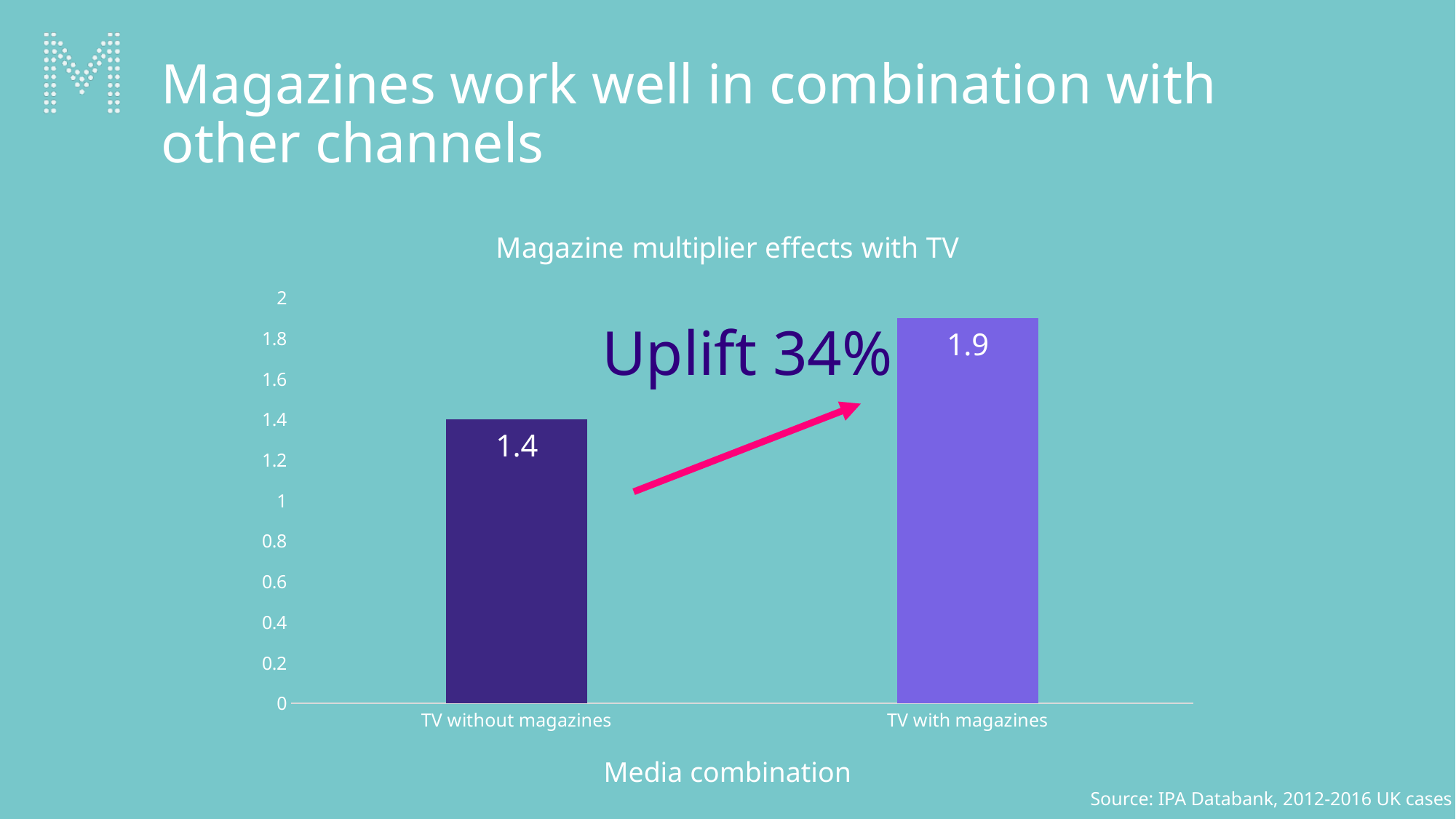
What is the title of the chart? Magazine multiplier effects with TV Which category has the lowest value? TV without magazines Which is larger, the value for TV with magazines or TV without magazines? TV with magazines Is the value for TV with magazines greater or less than 1.6? greater How many categories are shown on the x axis? 2 Which category has the highest value? TV with magazines What uplift percentage is annotated on the chart? 34% Is the value for TV without magazines greater or less than 1.6? less What kind of chart is shown? bar chart What is the difference between the values for TV with magazines and TV without magazines? 0.5 What is the value for TV with magazines? 1.9 What is the value for TV without magazines? 1.4